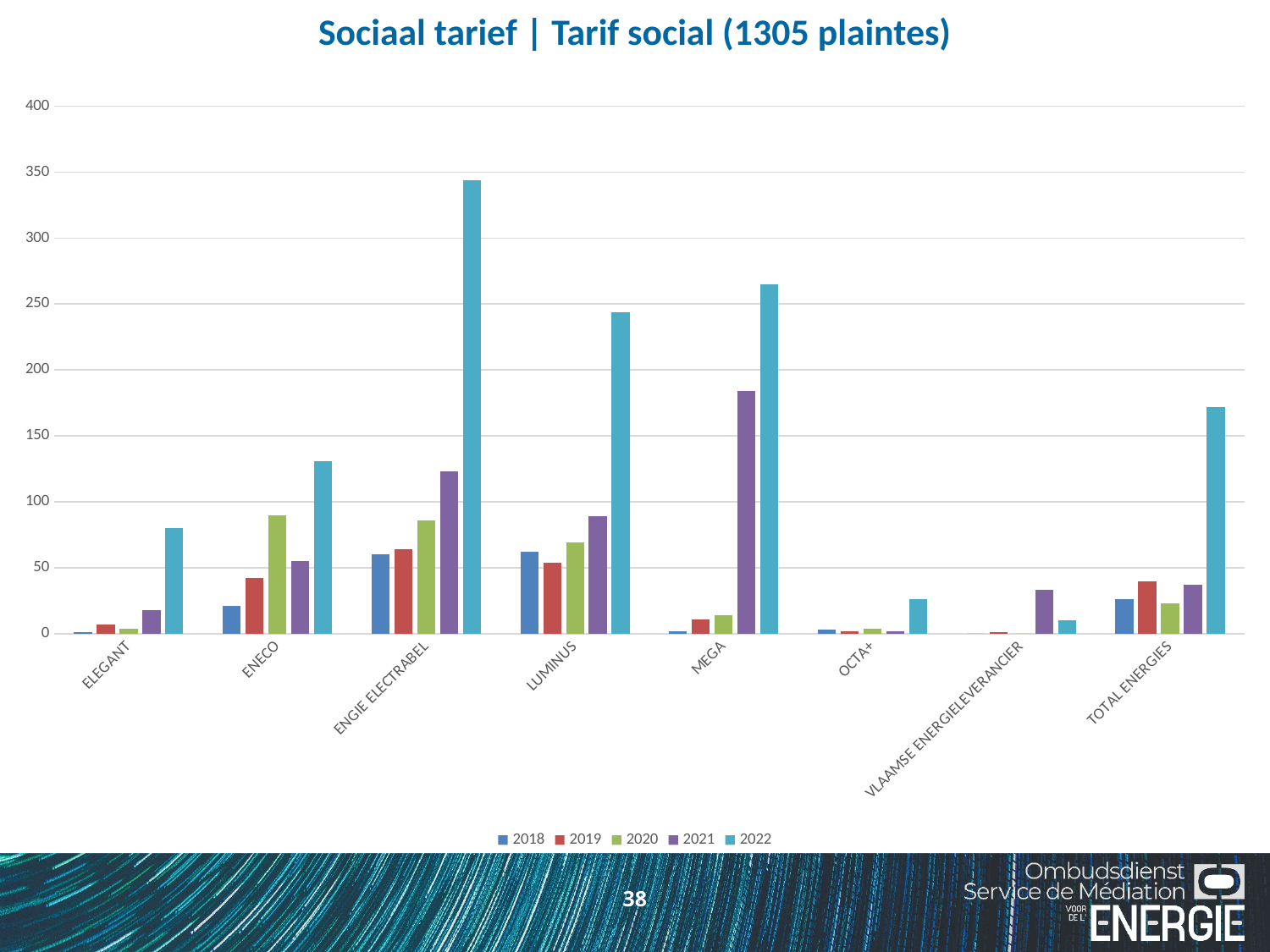
Which supplier has the highest bar in the chart? ENGIE ELECTRABEL Is the 2022 value for TOTAL ENERGIES greater or less than 150? greater For ENGIE ELECTRABEL, do the values rise or fall from 2018 to 2022? rise Is the 2022 value for ENGIE ELECTRABEL greater or less than 300? greater What is the title of the chart? Sociaal tarief | Tarif social (1305 plaintes) Which is larger for 2022: the value for LUMINUS or the value for MEGA? MEGA For ENGIE ELECTRABEL, which year has the highest value? 2022 How many series does the legend list? 5 Is the 2021 value for MEGA greater or less than 200? less What kind of chart is shown on the slide? Bar chart How many supplier categories are shown on the x axis? 8